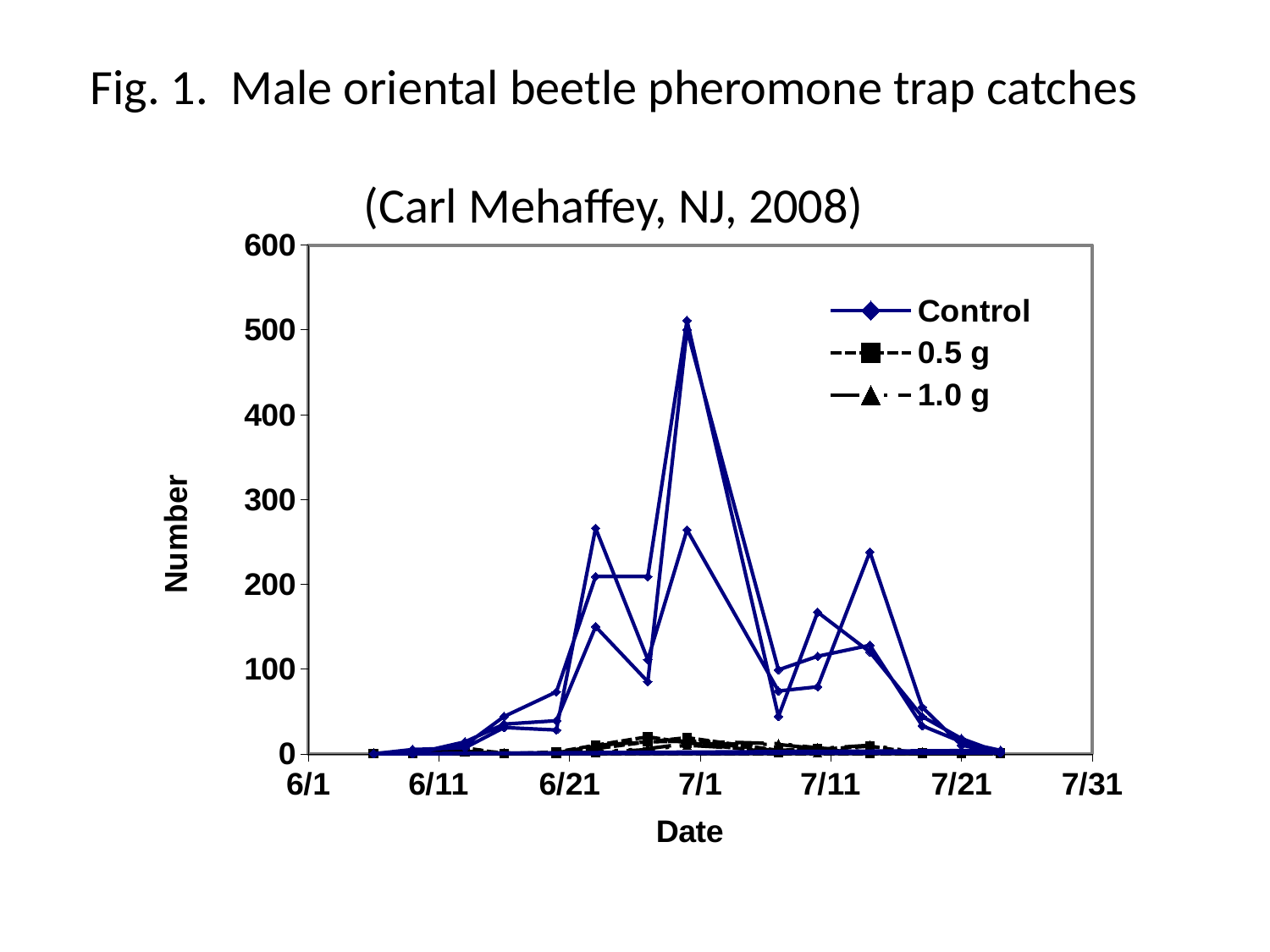
How many series does the legend list? 3 Do the Control values rise or fall between 7/11 and 7/21? fall Are the values for the 0.5 g series greater or less than 100 throughout the chart? less What kind of chart is shown on the slide? Line chart Are the values for the 1.0 g series greater or less than 100 throughout the chart? less What is the highest value shown on the y axis? 600 What is the label of the y axis? Number Do the Control values rise or fall between 6/11 and the peak near 7/1? rise Around 7/1, which series has the larger value, Control or 0.5 g? Control What are the three series named in the legend? Control, 0.5 g, 1.0 g Which series reaches the highest value on the chart? Control Is the highest Control value greater or less than 400? greater